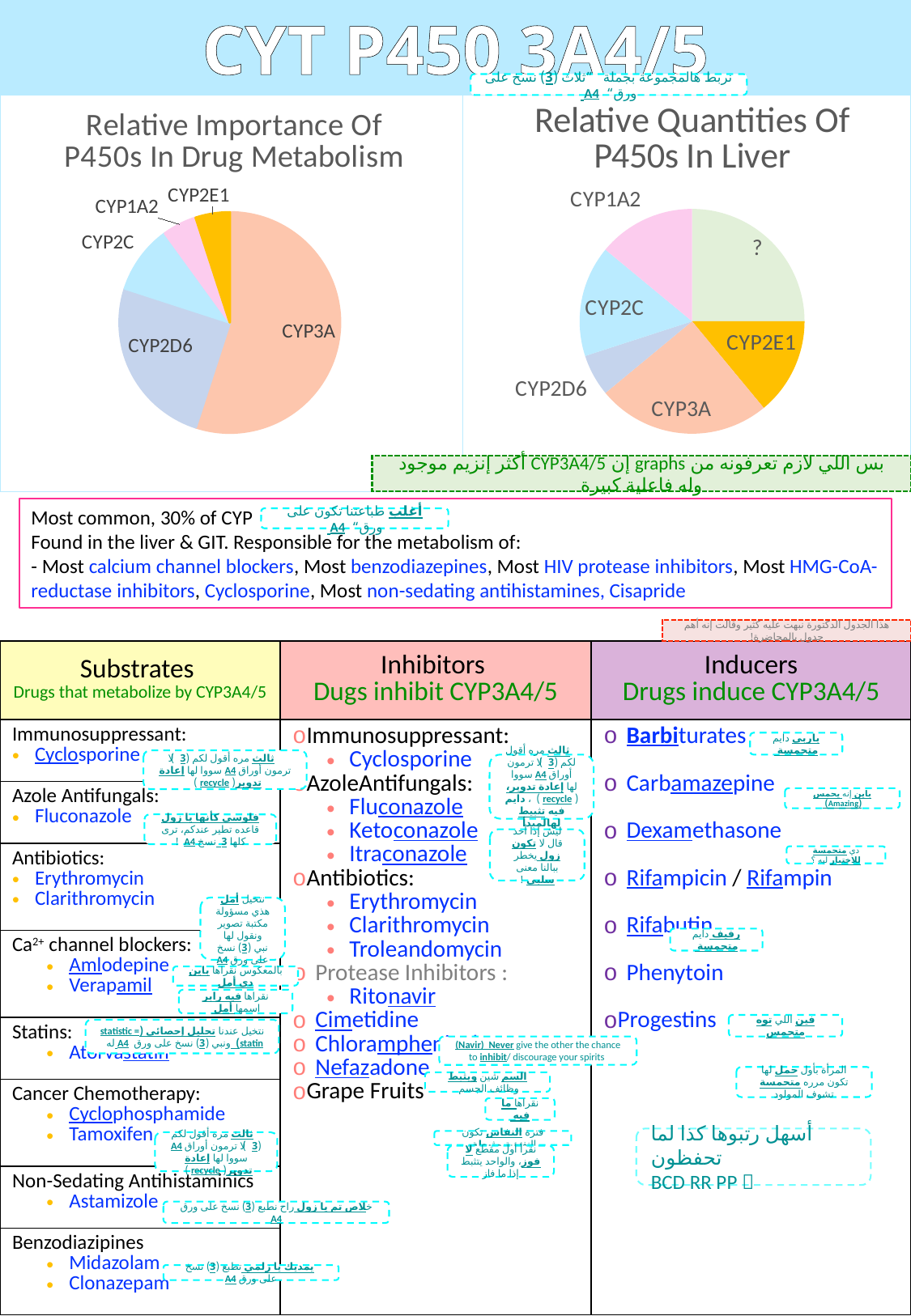
What kind of chart is "Relative Importance Of P450s In Drug Metabolism"? pie chart In the "Relative Quantities Of P450s In Liver" chart, which slice is larger, CYP3A or CYP2C? CYP3A In the "Relative Importance Of P450s In Drug Metabolism" chart, which slice is larger, CYP2D6 or CYP2E1? CYP2D6 How many slices does the "Relative Importance Of P450s In Drug Metabolism" pie chart have? 5 In the "Relative Quantities Of P450s In Liver" chart, which slice is larger, CYP3A or CYP2D6? CYP3A What is the title of the pie chart on the left side of the slide? Relative Importance Of P450s In Drug Metabolism In the "Relative Quantities Of P450s In Liver" chart, what label does the light green slice carry? ? In the "Relative Importance Of P450s In Drug Metabolism" chart, which enzyme has the largest slice? CYP3A What kind of chart is "Relative Quantities Of P450s In Liver"? pie chart How many slices does the "Relative Quantities Of P450s In Liver" pie chart have? 6